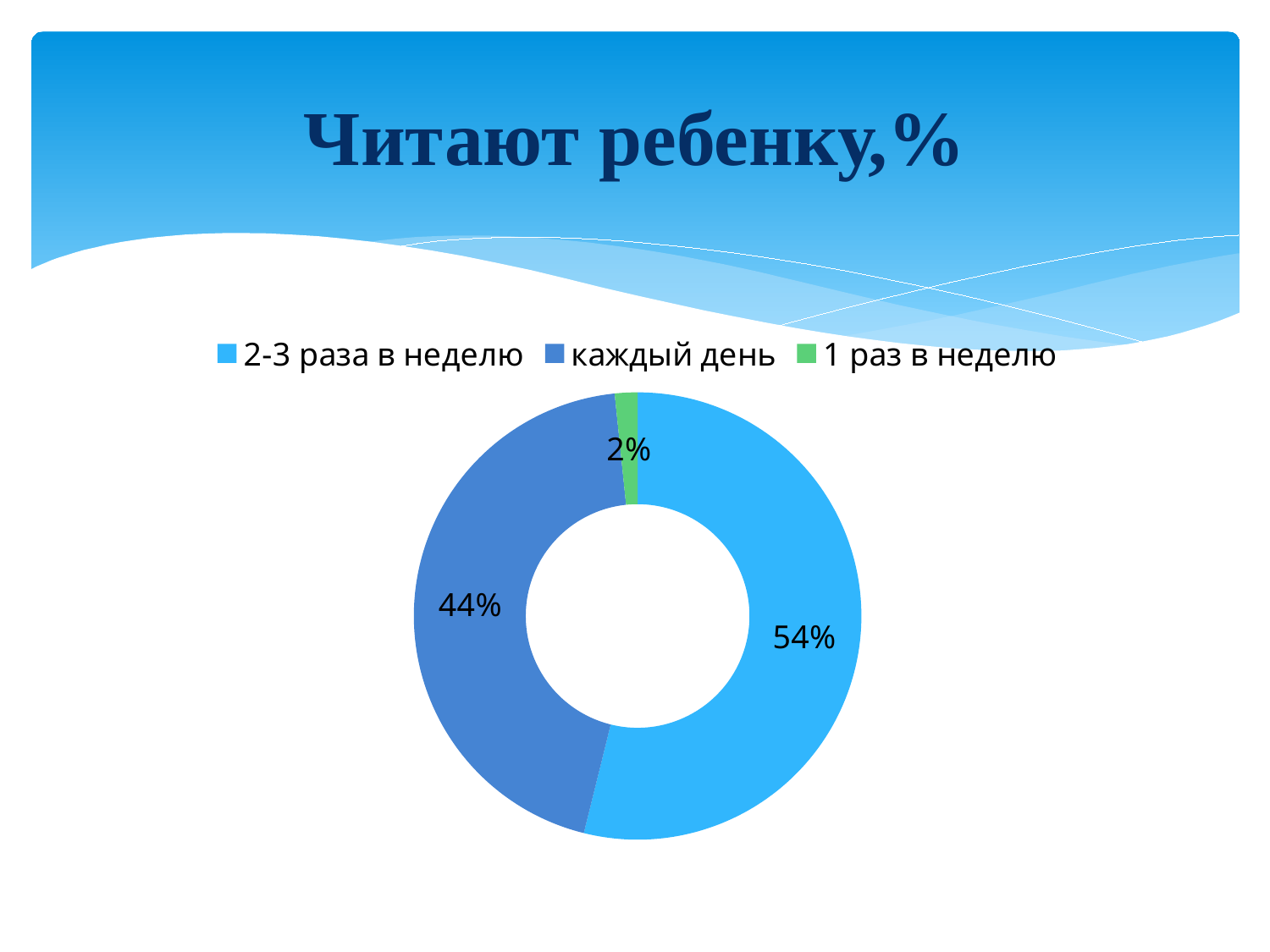
What is the title of the slide? Читают ребенку,% What share of the chart is labelled "2-3 раза в неделю"? 54% Which category has the smallest share of the chart? 1 раз в неделю What colour is the segment for "1 раз в неделю"? Green What is the difference in percentage points between "2-3 раза в неделю" and "каждый день"? 10 Which is larger, the share for "каждый день" or the share for "1 раз в неделю"? каждый день How many categories does the chart show? 3 What is the difference in percentage points between "каждый день" and "1 раз в неделю"? 42 What kind of chart is shown on the slide? Doughnut (pie) chart What share of the chart is labelled "1 раз в неделю"? 2% What share of the chart is labelled "каждый день"? 44% Which category has the largest share of the chart? 2-3 раза в неделю